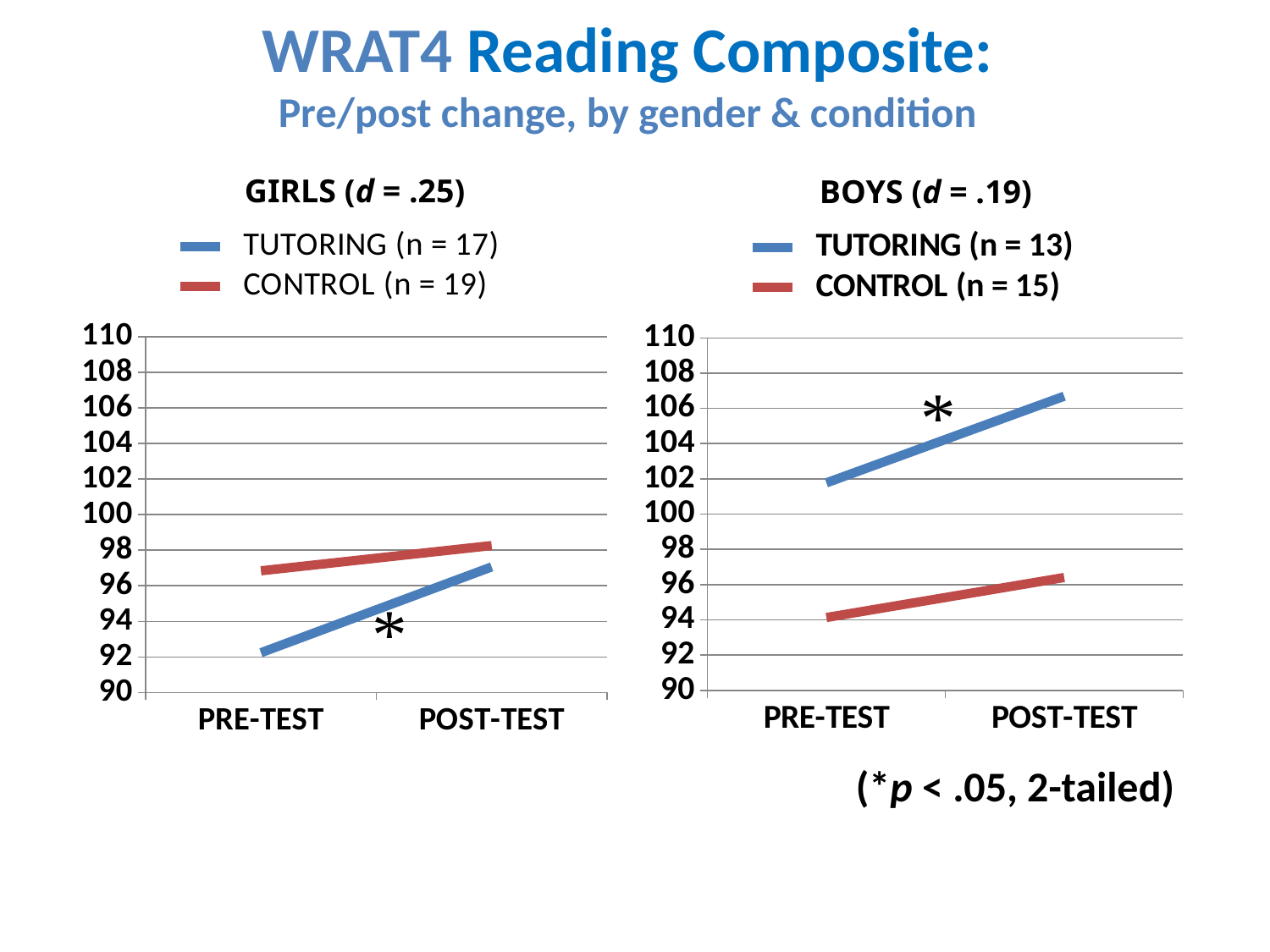
How many categories are on the x axis of the GIRLS chart? 2 In the BOYS chart, does the TUTORING line rise or fall from PRE-TEST to POST-TEST? rise What is the sample size (n) shown in the legend for the CONTROL group in the GIRLS chart? 19 In the BOYS chart, is the TUTORING value at PRE-TEST greater or less than 100? greater How many series does the legend of the BOYS chart list? 2 In the BOYS chart, is the CONTROL value at PRE-TEST greater or less than 96? less In the GIRLS chart, is the CONTROL value at POST-TEST greater or less than 100? less In the GIRLS chart, which series has the higher value at PRE-TEST, TUTORING or CONTROL? CONTROL What kind of chart is the GIRLS chart? line chart In the BOYS chart, which series has the higher value at POST-TEST, TUTORING or CONTROL? TUTORING